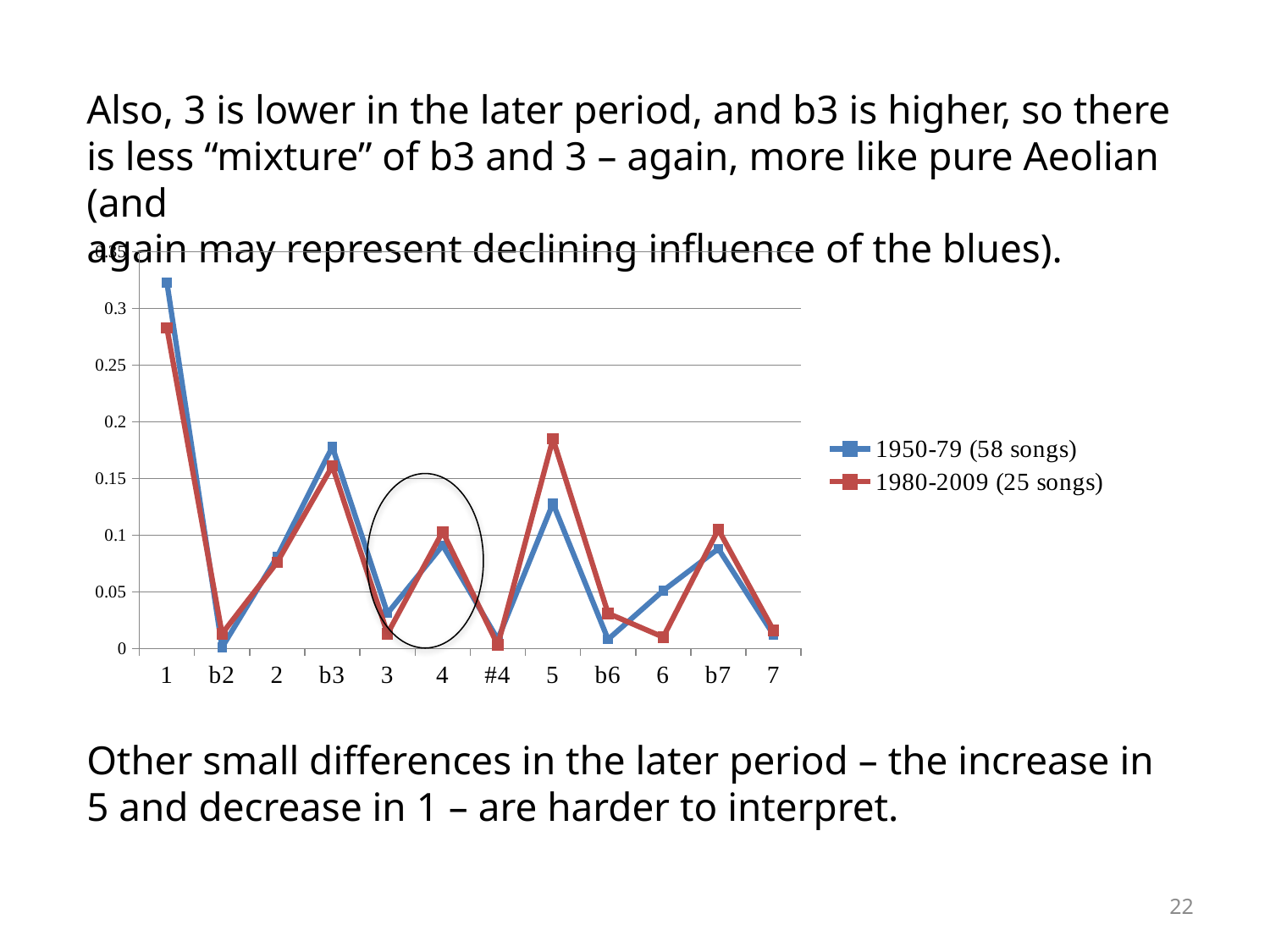
Is the value for category 1 in the 1950-79 (58 songs) series greater or less than 0.3? greater At category 1, which series has the larger value, 1950-79 (58 songs) or 1980-2009 (25 songs)? 1950-79 (58 songs) What kind of chart is shown on the slide? line chart Which category has the highest value for the 1950-79 (58 songs) series? 1 Is the value for category 5 in the 1980-2009 (25 songs) series greater or less than 0.15? greater Which category has the highest value for the 1980-2009 (25 songs) series? 1 At category 5, which series has the larger value, 1950-79 (58 songs) or 1980-2009 (25 songs)? 1980-2009 (25 songs) At category 6, which series has the larger value, 1950-79 (58 songs) or 1980-2009 (25 songs)? 1950-79 (58 songs) How many series does the legend list? 2 Is the value for category 5 in the 1950-79 (58 songs) series greater or less than 0.15? less What are the two legend entries of the chart? 1950-79 (58 songs) and 1980-2009 (25 songs) How many categories are shown along the x axis? 12